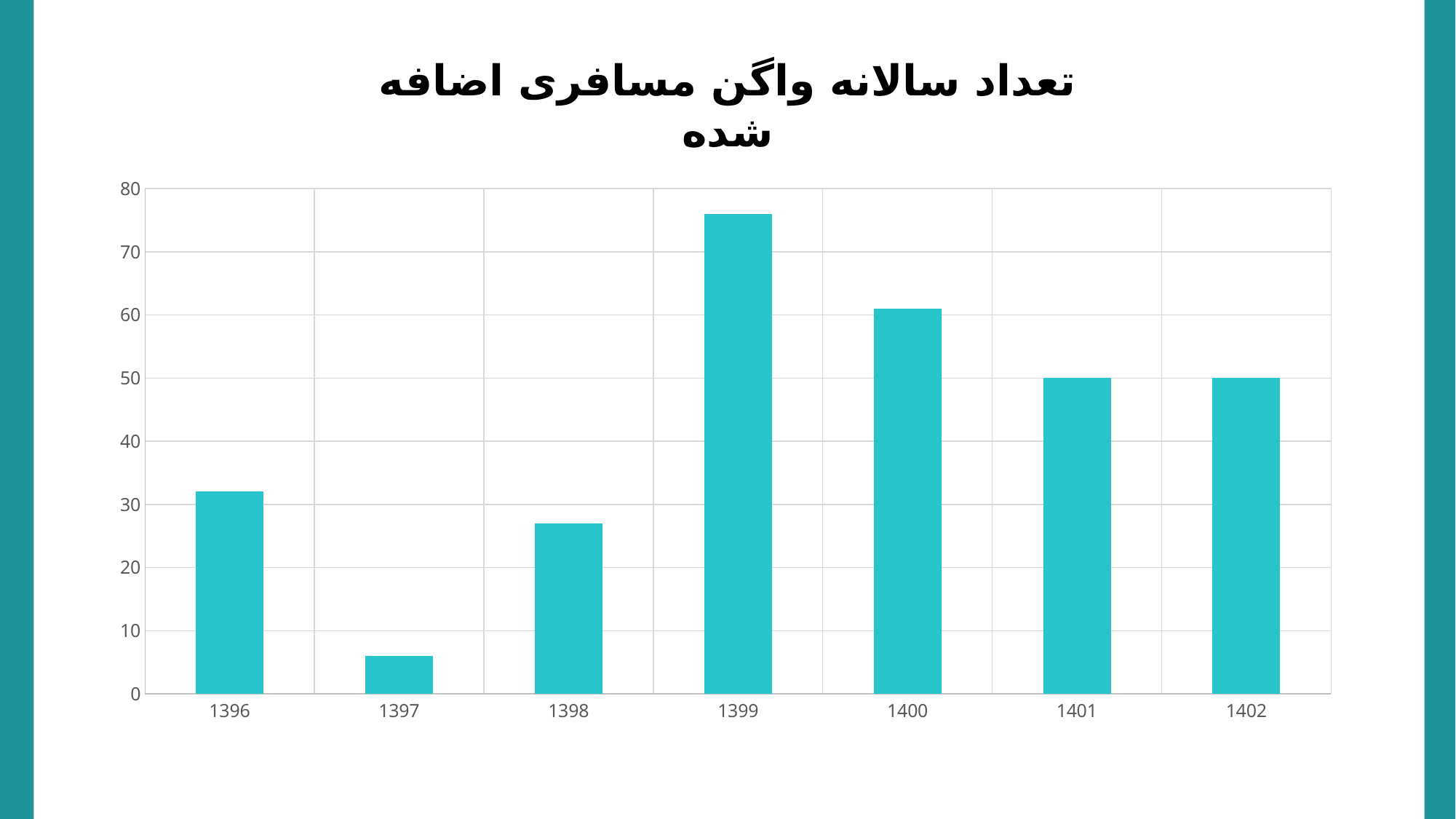
Which is larger, the value for 1396 or the value for 1398? 1396 How many years are shown on the x axis of the chart? 7 Which is larger, the value for 1399 or the value for 1400? 1399 Is the value for 1397 greater or less than 10? less What is the title of the chart? تعداد سالانه واگن مسافری اضافه شده What is the value for 1401? 50 Is the value for 1399 greater or less than 70? greater Which year has the highest bar in the chart? 1399 What is the value for 1402? 50 What kind of chart is shown on the slide? bar chart Which year has the lowest bar in the chart? 1397